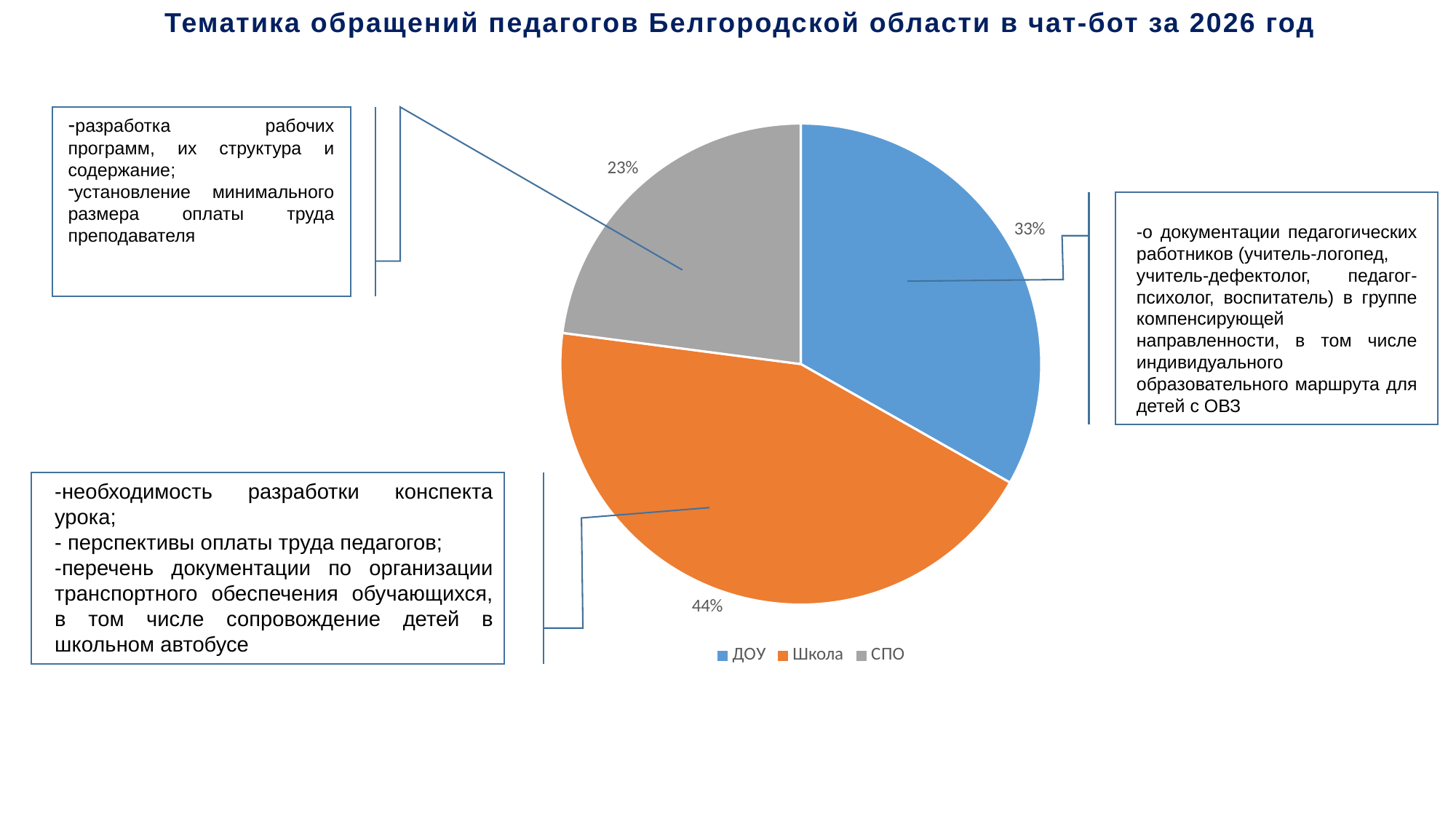
Which category has the largest slice of the pie? Школа How many categories does the pie chart have? 3 How many entries does the legend list? 3 What share of the pie does Школа have? 44% What kind of chart is shown on the slide? pie chart What colour is the Школа slice? orange What is the difference in percentage points between Школа and ДОУ? 11 Which category has the smallest slice of the pie? СПО What share of the pie does СПО have? 23% What share of the pie does ДОУ have? 33% Which is larger, the share for ДОУ or the share for СПО? ДОУ What is the difference in percentage points between ДОУ and СПО? 10